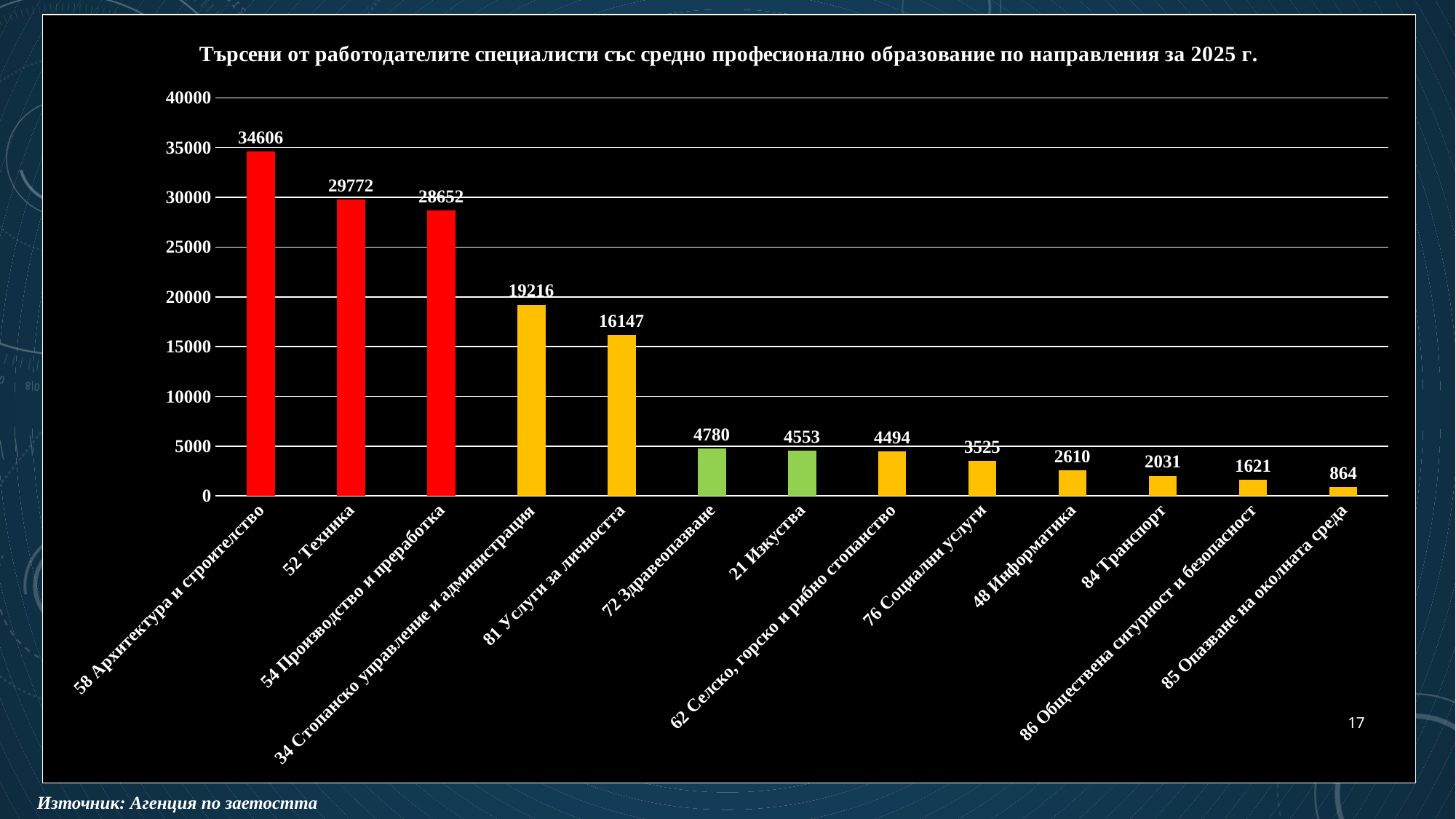
What is the difference between the values for 52 Техника and 54 Производство и преработка? 1120 How many categories are shown on the x axis? 13 Which category has the highest value? 58 Архитектура и строителство Do the values rise or fall from left to right along the x axis? fall What is the value for 58 Архитектура и строителство? 34606 Which category has the lowest value? 85 Опазване на околната среда What kind of chart is shown on the slide? bar chart What colour are the three tallest bars? red Is the value for 76 Социални услуги greater or less than 5000? less Which is larger, the value for 34 Стопанско управление и администрация or the value for 81 Услуги за личността? 34 Стопанско управление и администрация What is the value for 72 Здравеопазване? 4780 What is the value for 48 Информатика? 2610